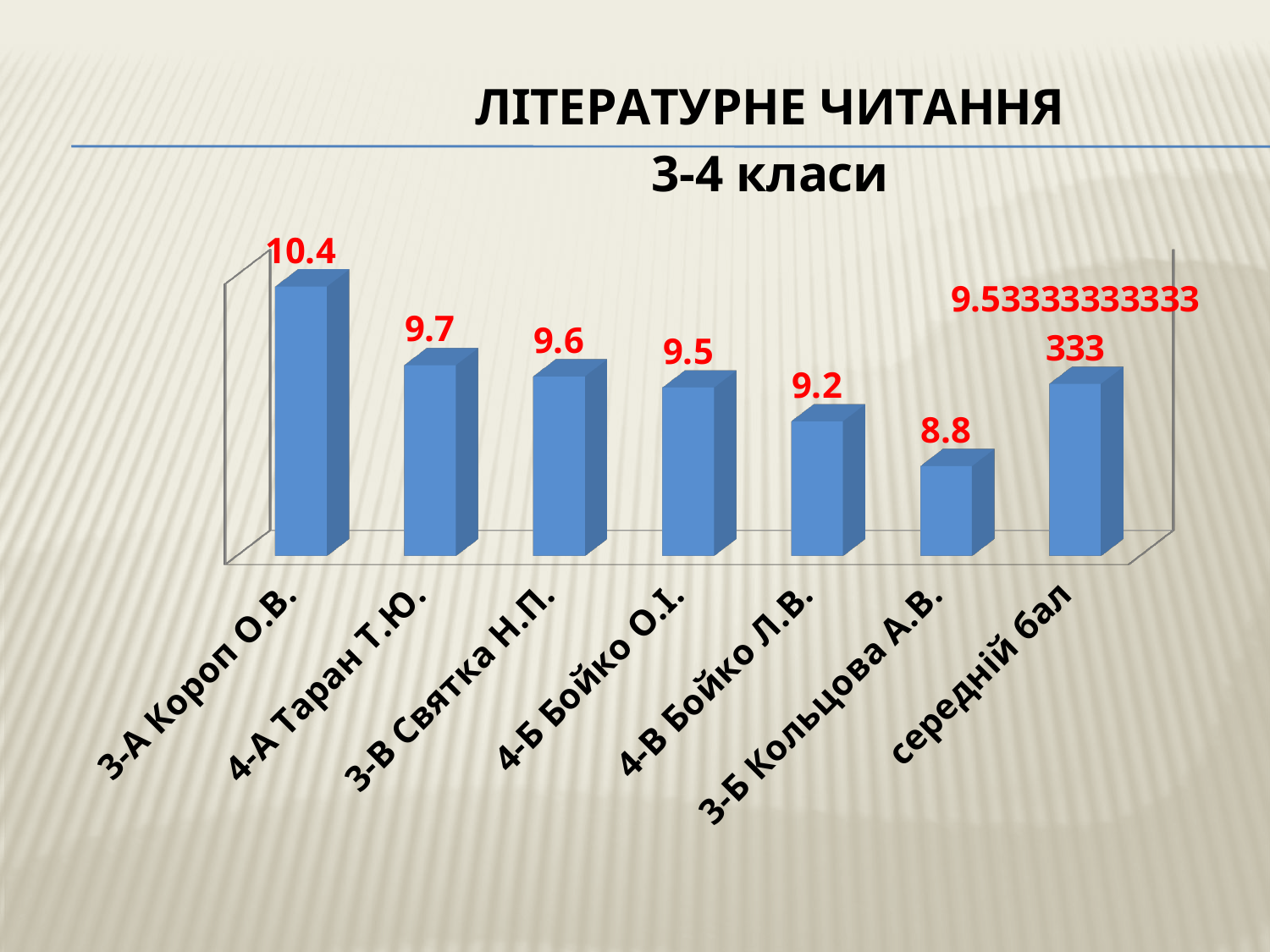
How many bars are shown in the chart? 7 What is the value for 3-А Короп О.В.? 10.4 What is the difference between the values for 4-А Таран Т.Ю. and 4-В Бойко Л.В.? 0.5 Which category has the lowest value? 3-Б Кольцова А.В. What type of chart is shown on the slide? bar chart What is the difference between the values for 3-А Короп О.В. and 3-Б Кольцова А.В.? 1.6 What is the value for 4-А Таран Т.Ю.? 9.7 What is the value for 4-В Бойко Л.В.? 9.2 What is the value for 3-Б Кольцова А.В.? 8.8 What is the title of the slide? ЛІТЕРАТУРНЕ ЧИТАННЯ Which category has the highest value? 3-А Короп О.В. Which is larger, the value for 3-В Святка Н.П. or the value for 4-Б Бойко О.І.? 3-В Святка Н.П.